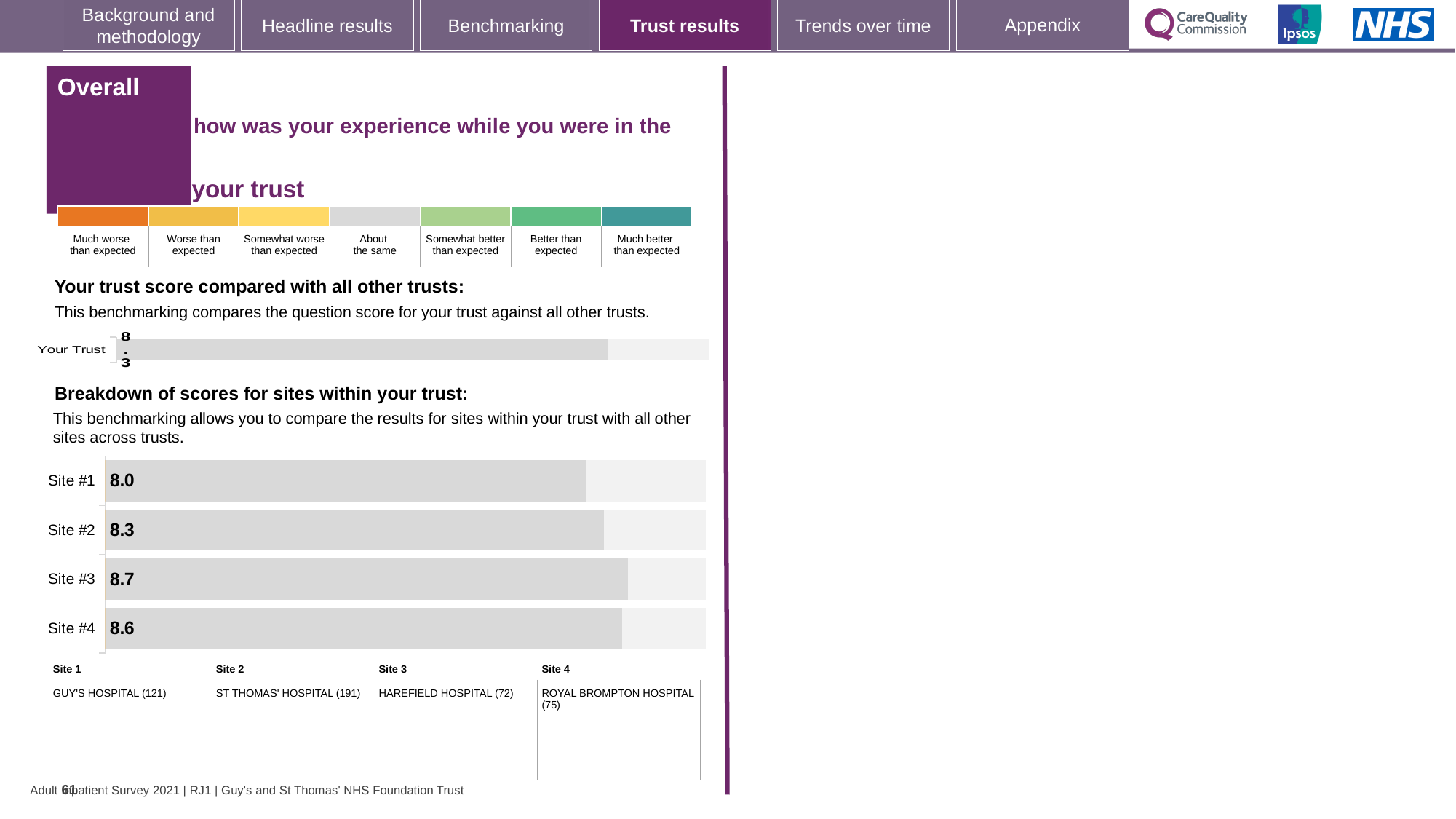
In the 'Breakdown of scores for sites within your trust' chart, what is the difference between the scores for Site #3 and Site #1? 0.7 In the 'Breakdown of scores for sites within your trust' chart, what is the score for Site #4? 8.6 In the 'Breakdown of scores for sites within your trust' chart, what is the score for Site #1? 8.0 What kind of chart is the 'Breakdown of scores for sites within your trust' chart? Bar chart In the 'Breakdown of scores for sites within your trust' chart, which site has the lowest score? Site #1 In the 'Breakdown of scores for sites within your trust' chart, what is the score for Site #3? 8.7 According to the site key below the 'Breakdown of scores for sites within your trust' chart, which hospital is Site 3? HAREFIELD HOSPITAL (72) In the 'Breakdown of scores for sites within your trust' chart, what is the difference between the scores for Site #2 and Site #1? 0.3 In the 'Breakdown of scores for sites within your trust' chart, which site has the highest score? Site #3 In the 'Breakdown of scores for sites within your trust' chart, which has the higher score, Site #2 or Site #4? Site #4 How many sites are shown in the 'Breakdown of scores for sites within your trust' chart? 4 In the 'Your trust score compared with all other trusts' chart, what is the score for Your Trust? 8.3